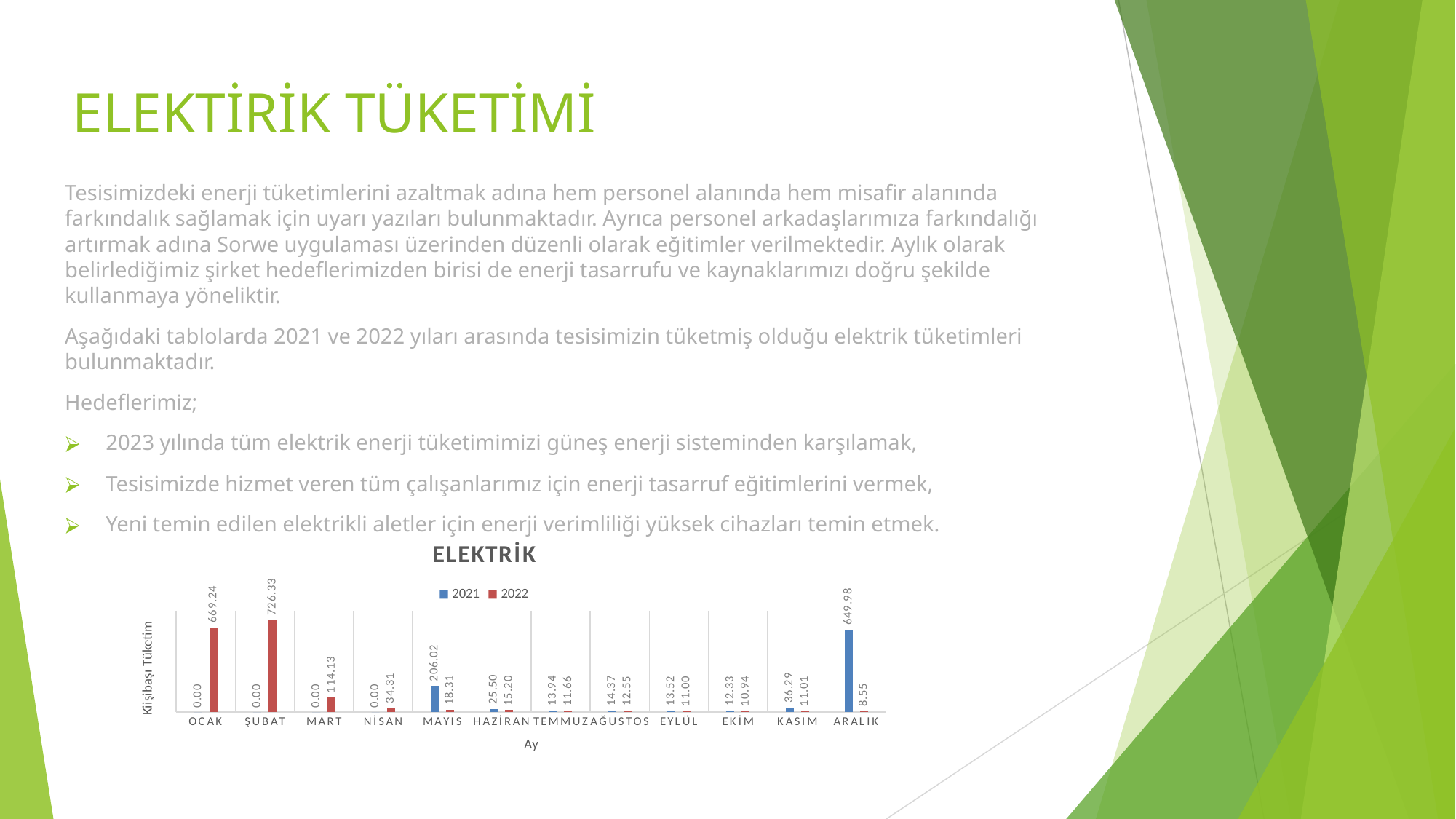
In the ELEKTRİK chart, which is larger for KASIM: the 2021 value or the 2022 value? 2021 What is the 2022 value for MART in the ELEKTRİK chart? 114.13 How many months are shown on the x axis of the ELEKTRİK chart? 12 How many series does the legend of the ELEKTRİK chart list? 2 What is the 2021 value for MAYIS in the ELEKTRİK chart? 206.02 What type of chart is the ELEKTRİK chart? Bar chart What is the 2021 value for ARALIK in the ELEKTRİK chart? 649.98 What is the difference between the 2022 values for ŞUBAT and OCAK in the ELEKTRİK chart? 57.09 Which month has the lowest 2022 value in the ELEKTRİK chart? ARALIK Which month has the highest 2022 value in the ELEKTRİK chart? ŞUBAT Which month has the highest 2021 value in the ELEKTRİK chart? ARALIK What is the 2022 value for ŞUBAT in the ELEKTRİK chart? 726.33